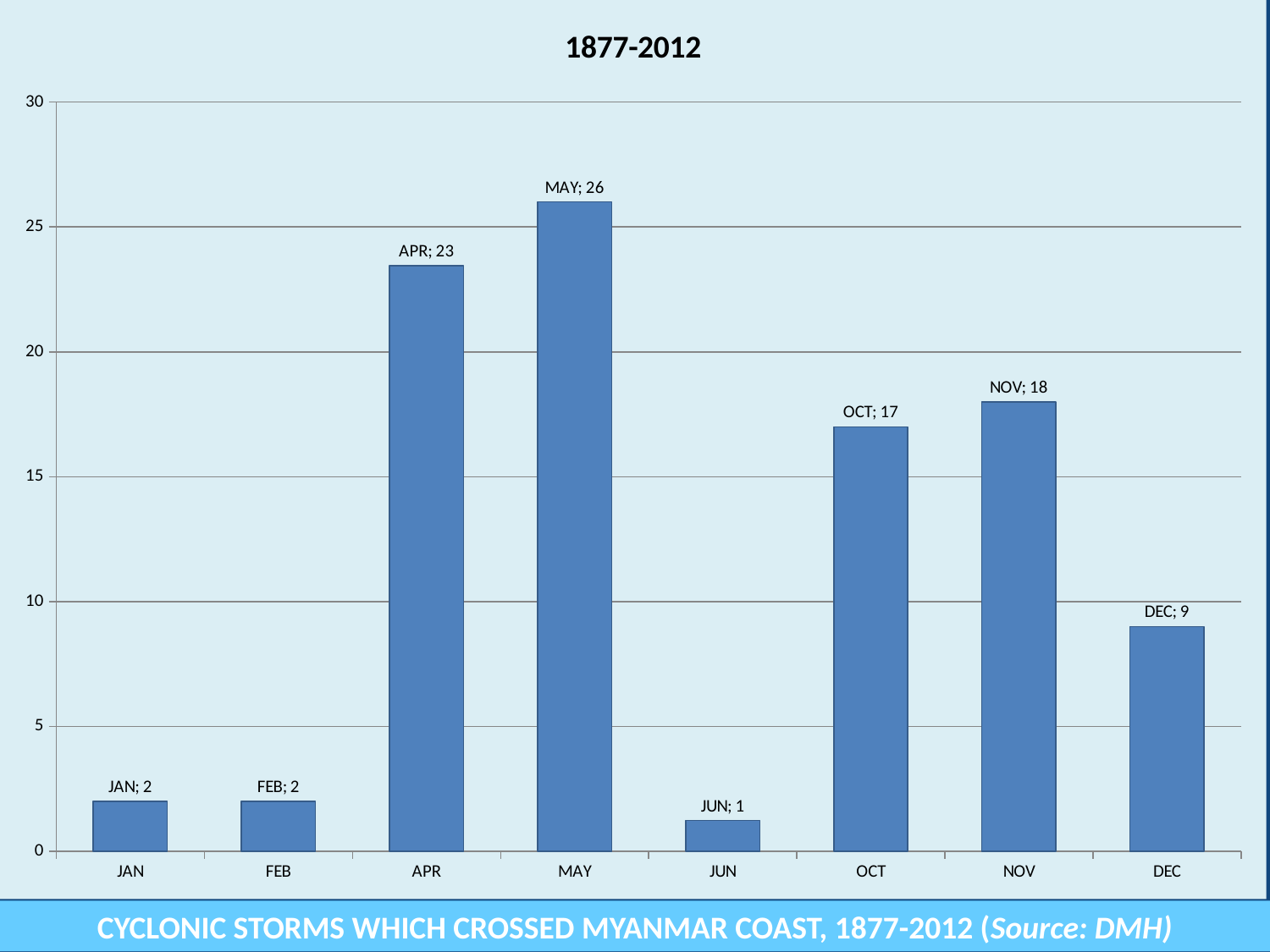
Is the value for APR greater or less than 20? greater What is the difference between the values for MAY and APR? 3 What is the difference between the values for NOV and DEC? 9 Which month has the highest value? MAY What kind of chart is shown on the slide? bar chart How many months are shown on the x axis? 8 What is the value for DEC? 9 Which month has the lowest value? JUN What is the value for MAY? 26 Which is larger, the value for OCT or the value for NOV? NOV What is the title shown above the chart? 1877-2012 What is the value for OCT? 17